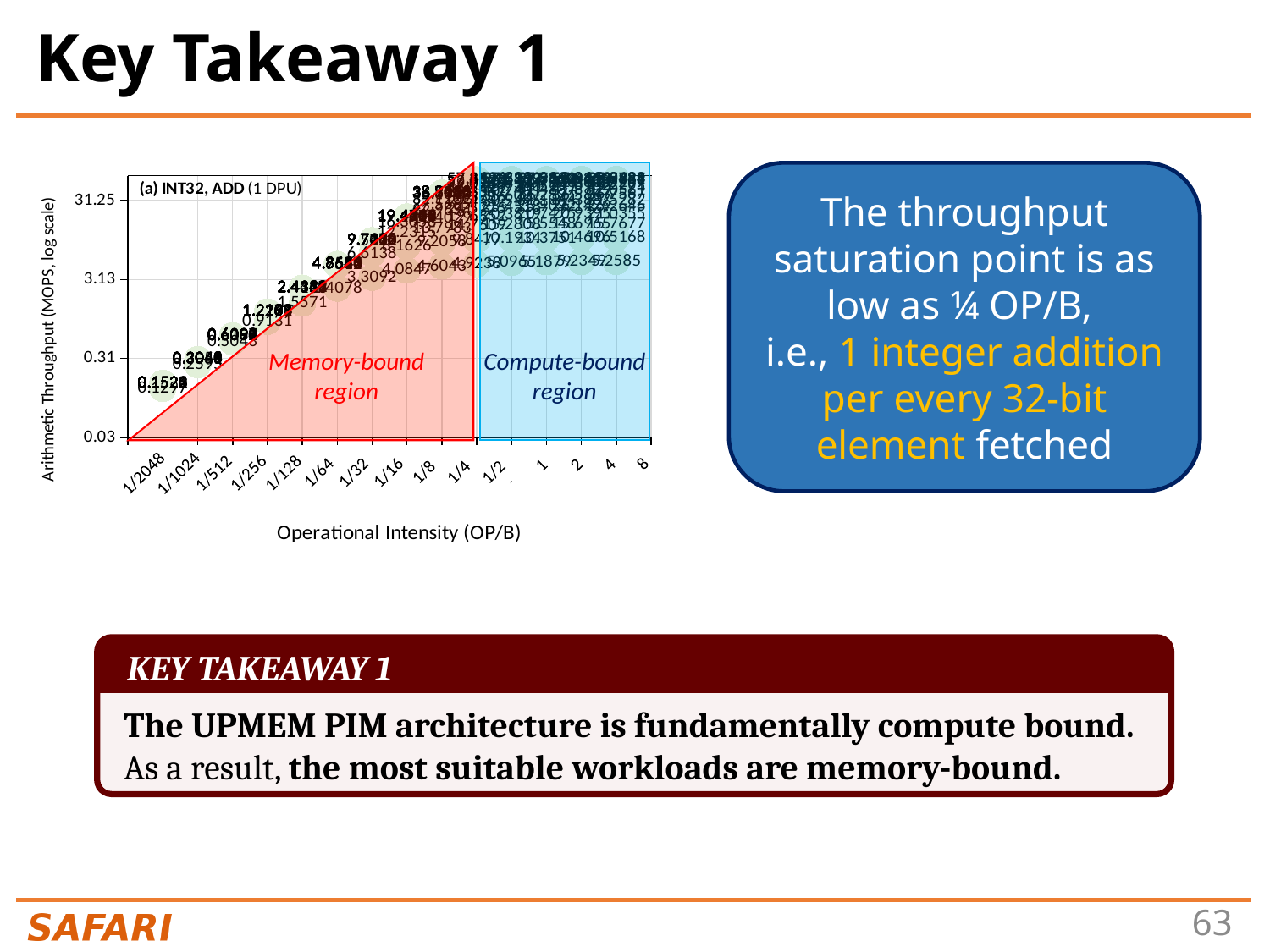
Which has the higher arithmetic throughput: an operational intensity of 1/2048 or 1/32? 1/32 What kind of chart is shown on the slide? scatter chart Which region of the chart is shaded blue: the memory-bound region or the compute-bound region? Compute-bound region Is the arithmetic throughput at an operational intensity of 1/128 greater or less than 3.13 MOPS? less Is the arithmetic throughput at an operational intensity of 1/1024 greater or less than 3.13 MOPS? less What is the label of the x axis of the chart? Operational Intensity (OP/B) What is the title shown inside the chart? (a) INT32, ADD (1 DPU) How many operational intensity values are marked on the x axis of the chart? 15 Does the arithmetic throughput rise or fall as operational intensity increases from 1/2048 to 1/4? rise Is the arithmetic throughput at an operational intensity of 1/2048 greater or less than 0.31 MOPS? less